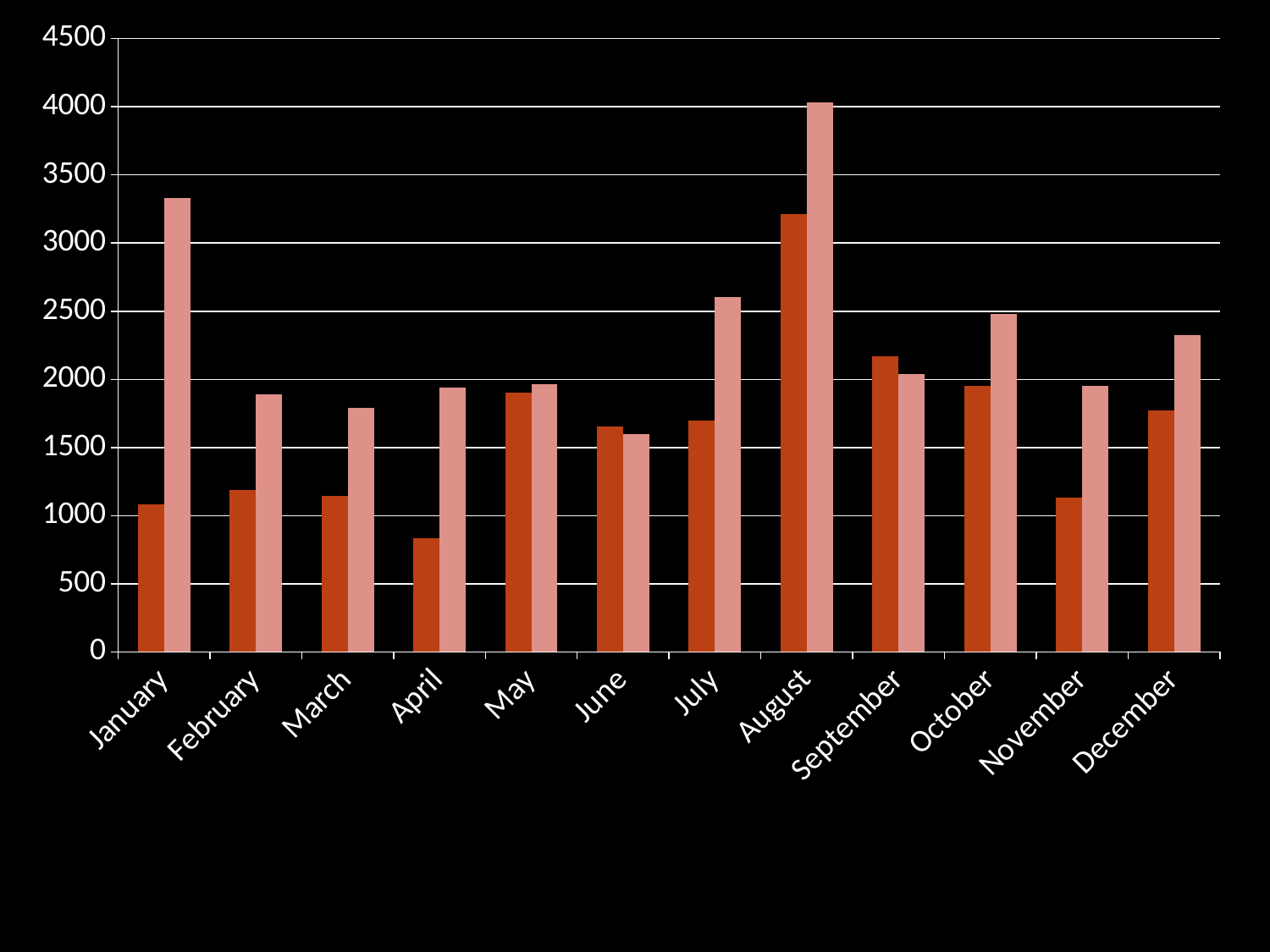
What kind of chart is shown on the slide? bar chart How many months are shown along the x axis? 12 In September, which bar is taller, the darker orange bar or the lighter pink bar? the darker orange bar Which month has the highest darker orange bar? August Which month has the highest lighter pink bar? August Which month has the lowest darker orange bar? April How many bars are plotted for each month? 2 Which month has the lowest lighter pink bar? June Is the darker orange bar for April greater or less than 1000? less Is the lighter pink bar for January greater or less than 3000? greater Which is taller, the lighter pink bar for July or the lighter pink bar for October? July